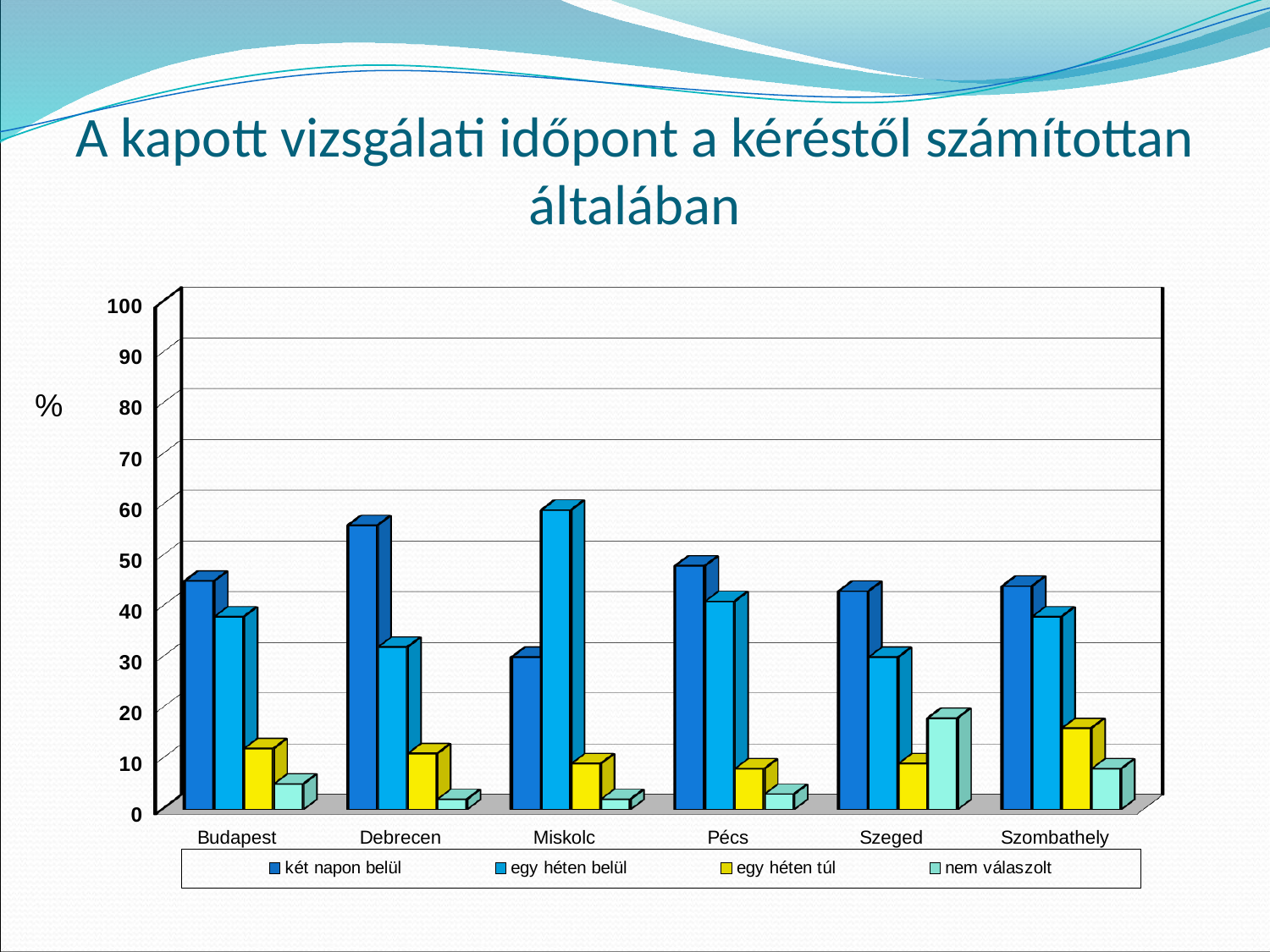
Which city has the lowest value for 'két napon belül'? Miskolc Is the 'két napon belül' value for Miskolc greater or less than 40? less How many cities are shown on the x axis of the chart? 6 Which city has the highest value for 'nem válaszolt'? Szeged Is the 'két napon belül' value for Debrecen greater or less than 50? greater What is the title of the chart on the slide? A kapott vizsgálati időpont a kéréstől számítottan általában For Miskolc, which is larger: 'két napon belül' or 'egy héten belül'? egy héten belül Is the 'nem válaszolt' value for Szeged greater or less than 10? greater Which city has the highest value for 'egy héten belül'? Miskolc What kind of chart is shown on the slide? bar chart Which city has the highest value for 'két napon belül'? Debrecen How many series does the chart's legend list? 4